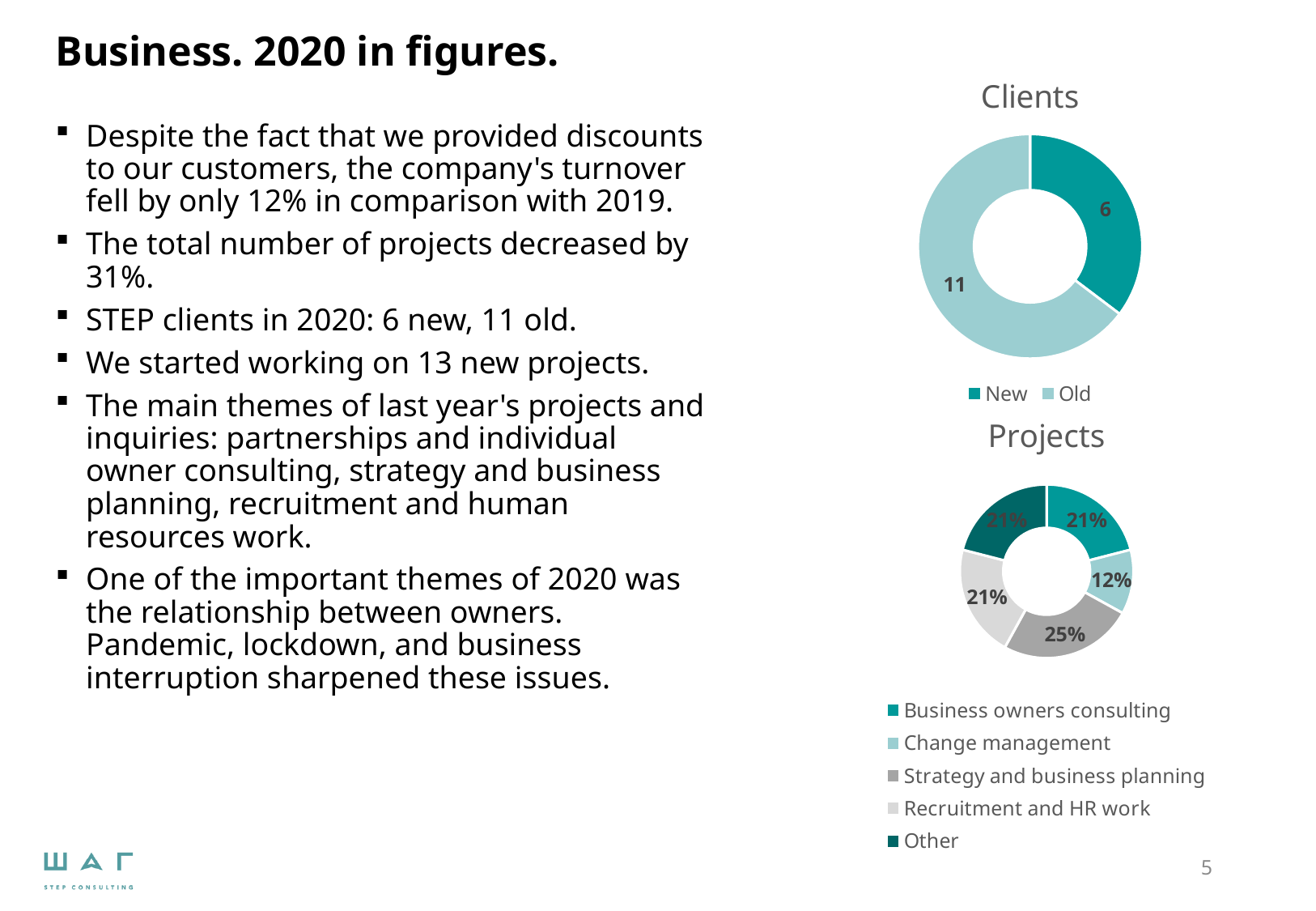
In the Clients chart, what is the total of the two segments? 17 In the Projects chart, which category has the largest share? Strategy and business planning In the Projects chart, what share is Change management? 12% In the Clients chart, what is the difference between the Old and New values? 5 In the Clients chart, how many new clients are shown? 6 In the Clients chart, what is the value for Old? 11 In the Clients chart, which category is larger, New or Old? Old How many categories does the Projects chart legend list? 5 What kind of chart is the Clients chart? Donut (pie) chart In the Projects chart, what is the difference between the shares of Strategy and business planning and Change management? 13% In the Projects chart, what share is Strategy and business planning? 25% In the Projects chart, which category has the smallest share? Change management